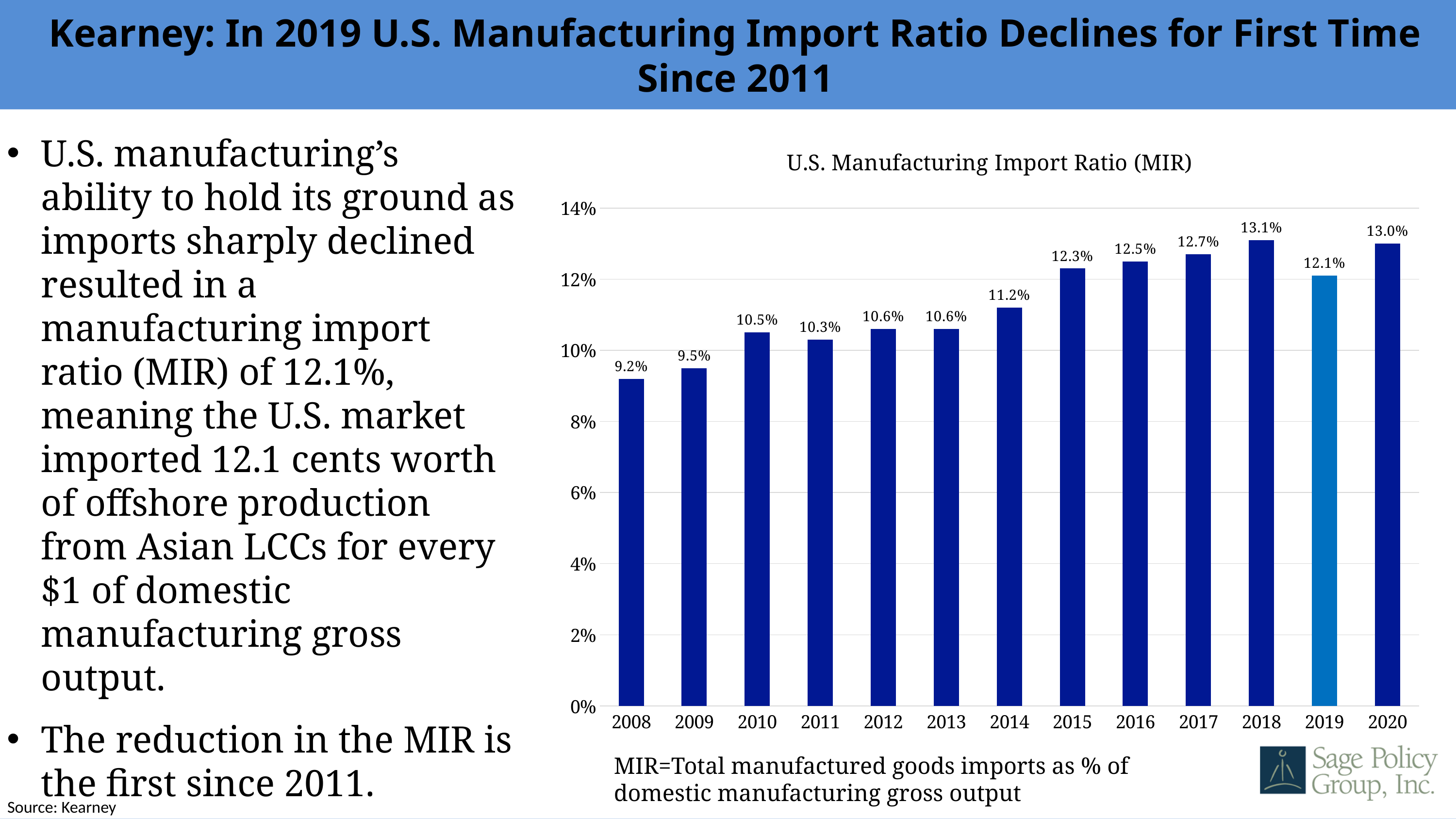
Do the MIR values generally rise or fall from 2008 to 2018? rise What is the U.S. Manufacturing Import Ratio for 2014? 11.2% What is the difference between the MIR in 2018 and the MIR in 2019? 1.0% Which year's bar is shown in a lighter blue colour than the others? 2019 How many years are shown on the x axis of the chart? 13 What kind of chart is used to show the U.S. Manufacturing Import Ratio? bar chart Which year has the highest U.S. Manufacturing Import Ratio? 2018 What is the U.S. Manufacturing Import Ratio for 2019? 12.1% Is the value for 2011 greater or less than 12%? less Which year has the lowest U.S. Manufacturing Import Ratio? 2008 What is the U.S. Manufacturing Import Ratio for 2008? 9.2% Which year has a higher MIR, 2015 or 2020? 2020